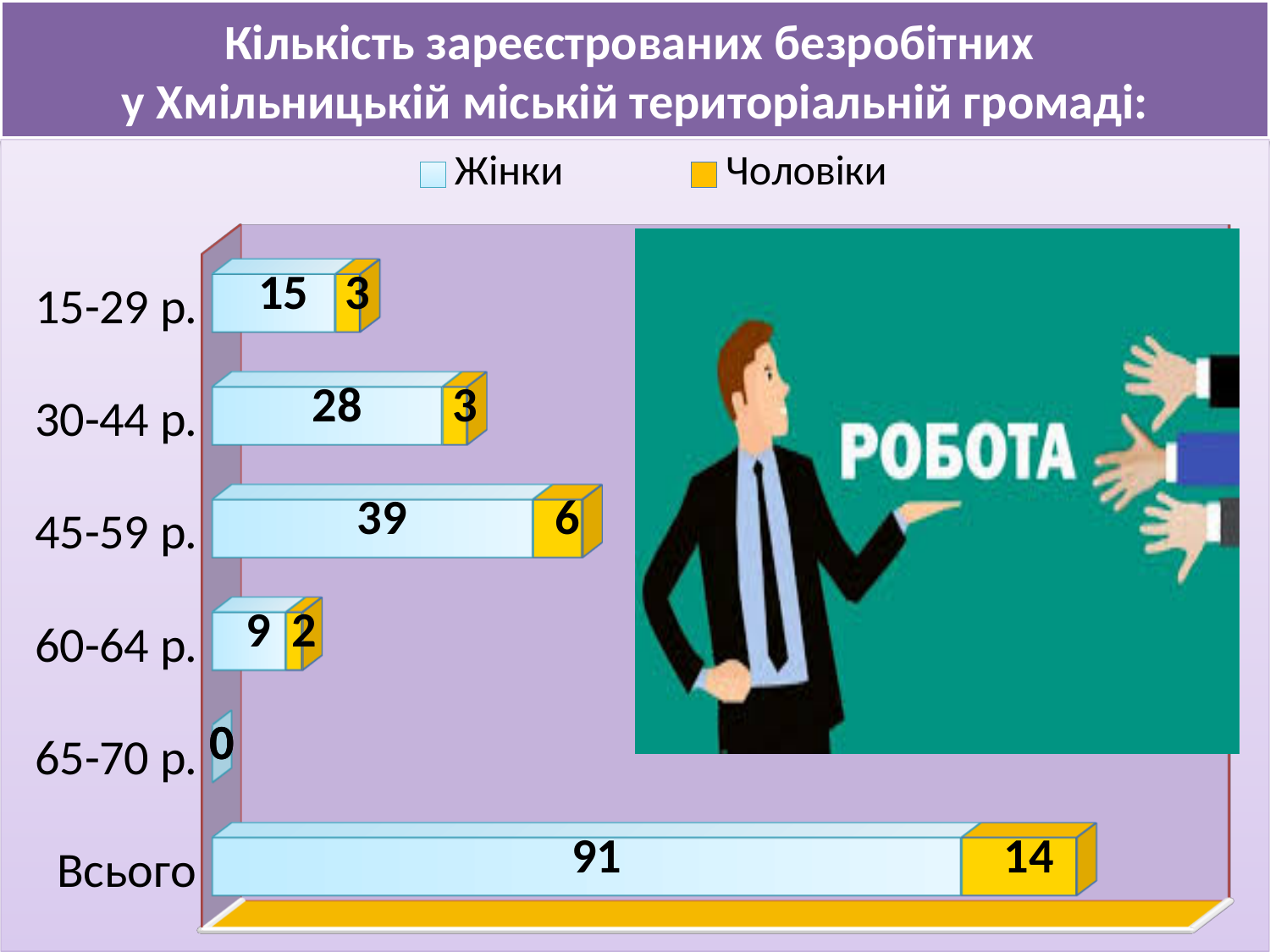
What is the total of the stacked bar for the 45-59 р. category? 45 How many series does the legend list? 2 Among the age groups (excluding Всього), which category has the lowest value for Жінки? 65-70 р. What kind of chart is shown on the slide? bar chart What are the two series named in the legend? Жінки and Чоловіки Among the age groups (excluding Всього), which category has the highest value for Жінки? 45-59 р. What is the value for Жінки in the Всього category? 91 What is the value for Чоловіки in the 60-64 р. category? 2 What is the value for Чоловіки in the 15-29 р. category? 3 How many categories are shown on the chart? 6 What is the difference between the Жінки values for 30-44 р. and 15-29 р.? 13 What is the value for Жінки in the 45-59 р. category? 39